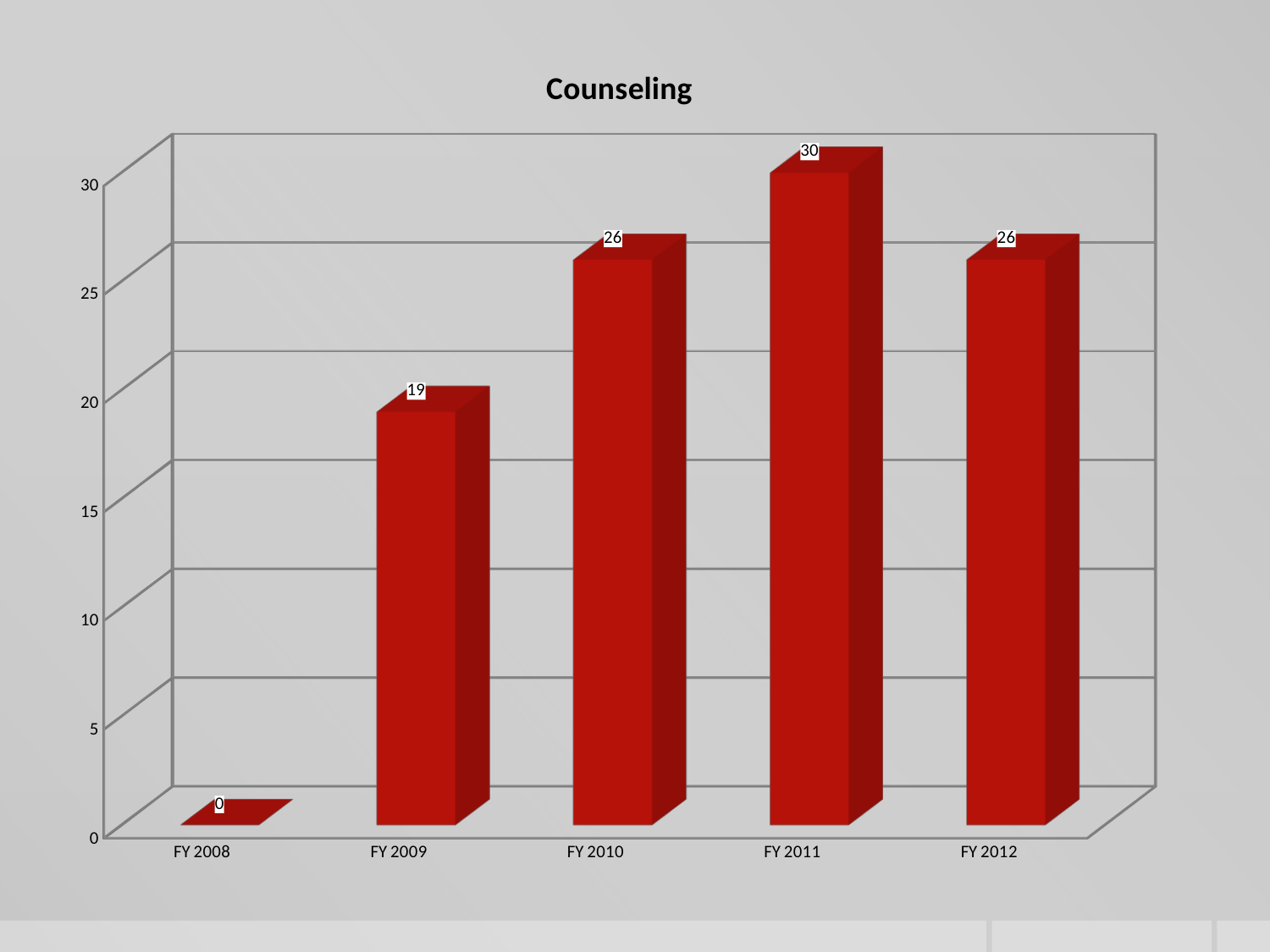
What is the value for FY 2009? 19 Which fiscal year has the highest value? FY 2011 What is the difference between the values for FY 2010 and FY 2009? 7 Which is larger, the value for FY 2009 or the value for FY 2012? FY 2012 What is the value for FY 2011? 30 What is the value for FY 2012? 26 How many fiscal years are shown on the x axis? 5 What kind of chart is this? bar chart Which fiscal year has the lowest value? FY 2008 What is the title of the chart? Counseling What is the value for FY 2008? 0 What is the difference between the values for FY 2011 and FY 2009? 11